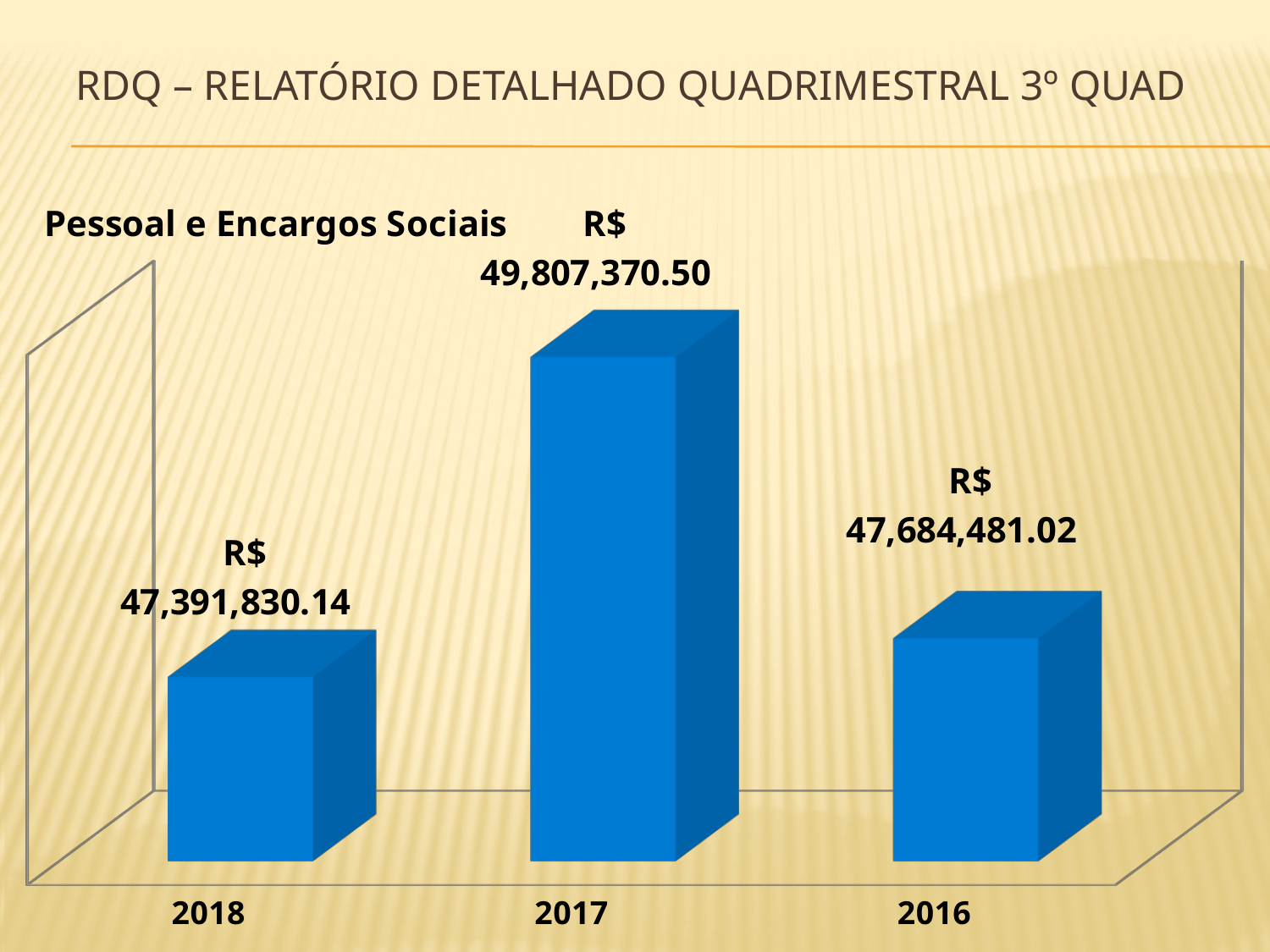
Which is larger, the value for 2016 or the value for 2018? 2016 What is the title of the chart? Pessoal e Encargos Sociais Which year has the highest value? 2017 What is the value for 2016? R$ 47,684,481.02 What is the difference between the values for 2017 and 2016? R$ 2,122,889.48 What is the value for 2017? R$ 49,807,370.50 Which year has the lowest value? 2018 What is the difference between the values for 2016 and 2018? R$ 292,650.88 What kind of chart is shown on the slide? Bar chart What is the difference between the values for 2017 and 2018? R$ 2,415,540.36 How many years are shown on the chart? 3 What is the value for 2018? R$ 47,391,830.14